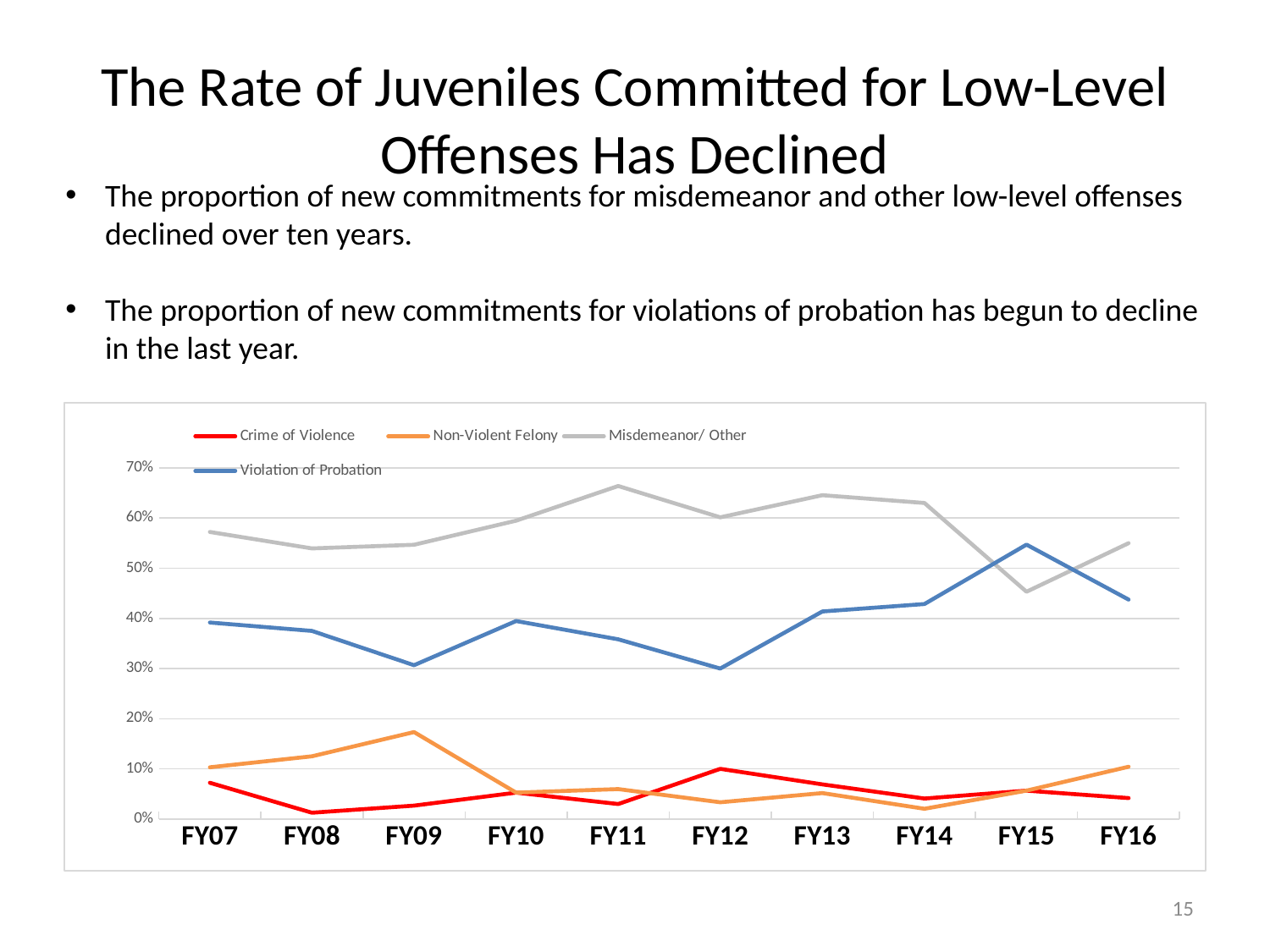
What kind of chart is shown on the slide? line chart In which fiscal year does the Non-Violent Felony line reach its highest value? FY09 How many series does the chart's legend list? 4 Is the Misdemeanor/ Other value for FY11 greater or less than 60%? greater Is the Non-Violent Felony value for FY09 greater or less than 20%? less Does the Violation of Probation line rise or fall from FY12 to FY15? rise In which fiscal year does the Misdemeanor/ Other line reach its highest value? FY11 Is the Violation of Probation value for FY15 greater or less than 50%? greater In FY15, which series has the higher value: Violation of Probation or Misdemeanor/ Other? Violation of Probation In which fiscal year does the Violation of Probation line reach its highest value? FY15 In which fiscal year is the Misdemeanor/ Other line at its lowest? FY15 How many fiscal years are plotted along the x axis? 10